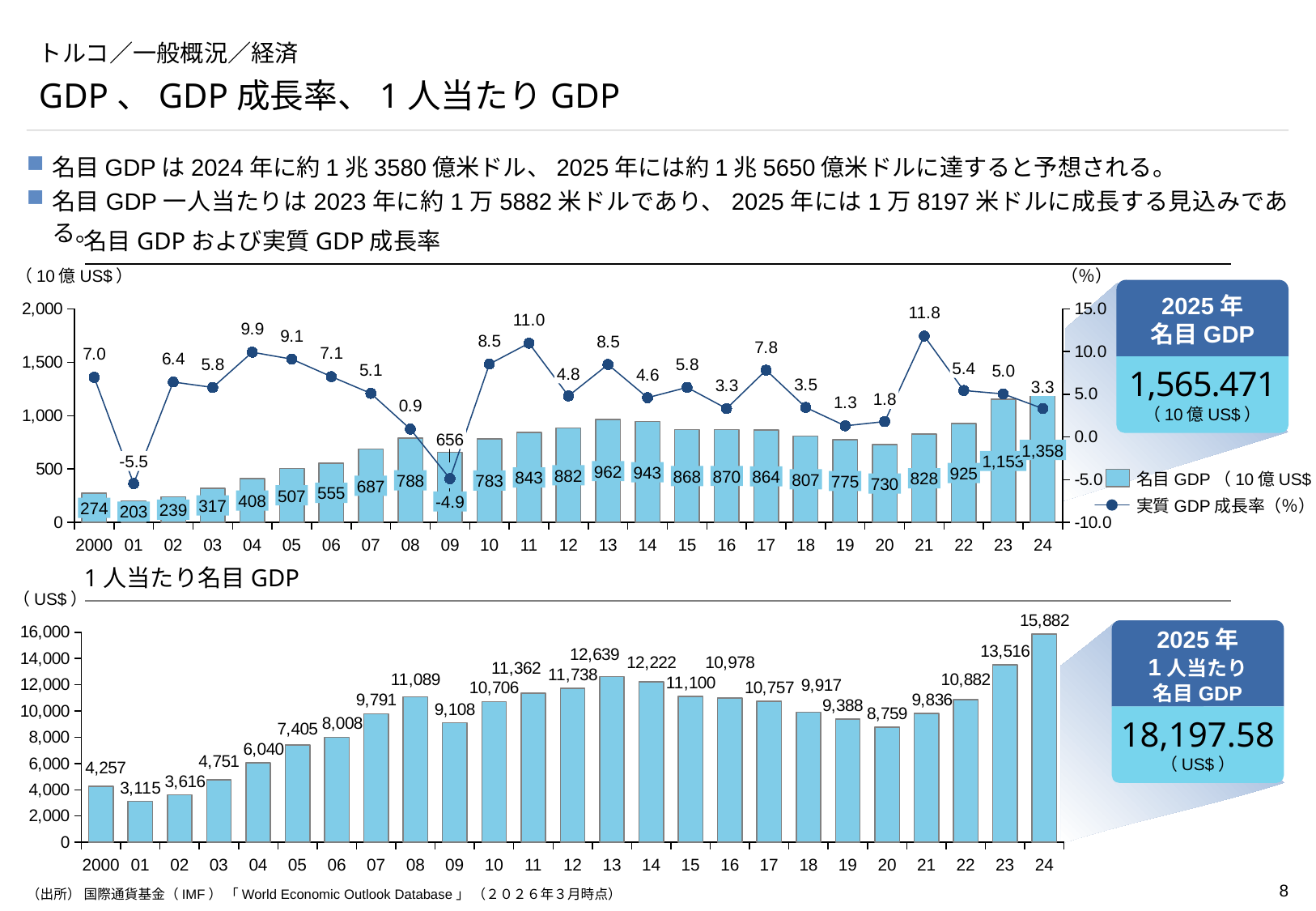
In the bottom chart (1人当たり名目GDP), which is larger, the value for 2008 or the value for 2016? 2016 How many series does the legend of the top chart (名目GDPおよび実質GDP成長率) list? 2 How many years are plotted in the bottom chart (1人当たり名目GDP)? 25 In the bottom chart (1人当たり名目GDP), what is the difference between the values for 2024 and 2023? 2,366 In the top chart (名目GDPおよび実質GDP成長率), which year has the highest nominal GDP? 2024 In the top chart (名目GDPおよび実質GDP成長率), what is the difference between the nominal GDP for 2024 and 2023? 205 In the top chart (名目GDPおよび実質GDP成長率), what is the real GDP growth rate for 2021? 11.8 What kind of chart is the bottom chart (1人当たり名目GDP)? bar chart In the bottom chart (1人当たり名目GDP), which year has the lowest value? 2001 In the top chart (名目GDPおよび実質GDP成長率), which year has the lowest real GDP growth rate? 2001 In the bottom chart (1人当たり名目GDP), what is the value for 2013? 12,639 In the top chart (名目GDPおよび実質GDP成長率), what is the nominal GDP value for 2013? 962